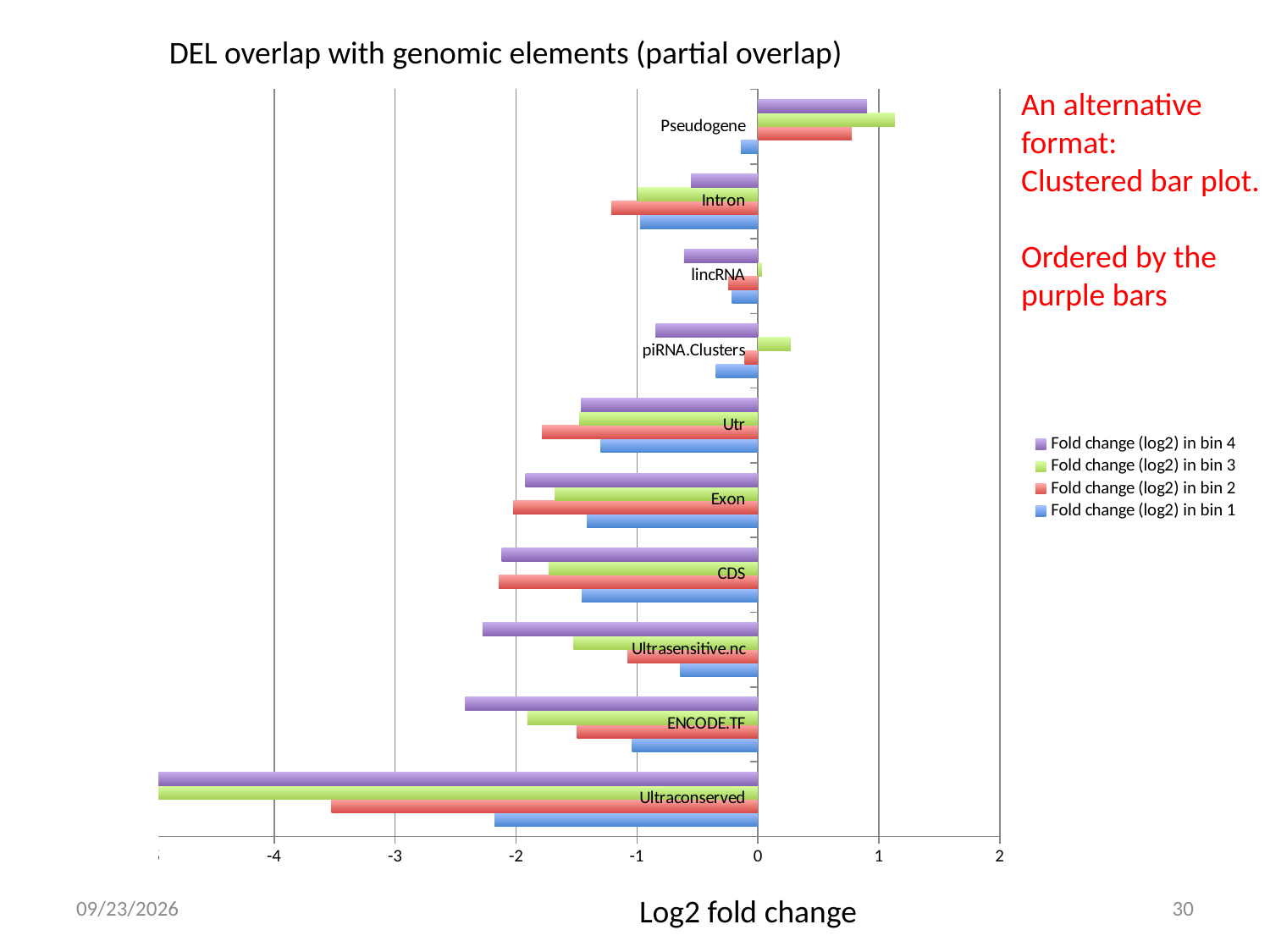
How many series does the chart's legend list? 4 Which category has the lowest value for Fold change (log2) in bin 4? Ultraconserved Which category has the lowest value for Fold change (log2) in bin 3? Ultraconserved How many genomic element categories are plotted on the chart? 10 What is the label on the horizontal axis of the chart? Log2 fold change Which category has the highest value for Fold change (log2) in bin 4? Pseudogene For Pseudogene, which is larger: the value in bin 3 or the value in bin 4? bin 3 What kind of chart is shown on the slide? Bar chart Is the value for Ultraconserved in bin 4 greater or less than -4? less Is the value for ENCODE.TF in bin 4 greater or less than -2? less Is the value for Pseudogene in bin 3 greater or less than 1? greater For Ultraconserved, which is larger: the value in bin 1 or the value in bin 2? bin 1